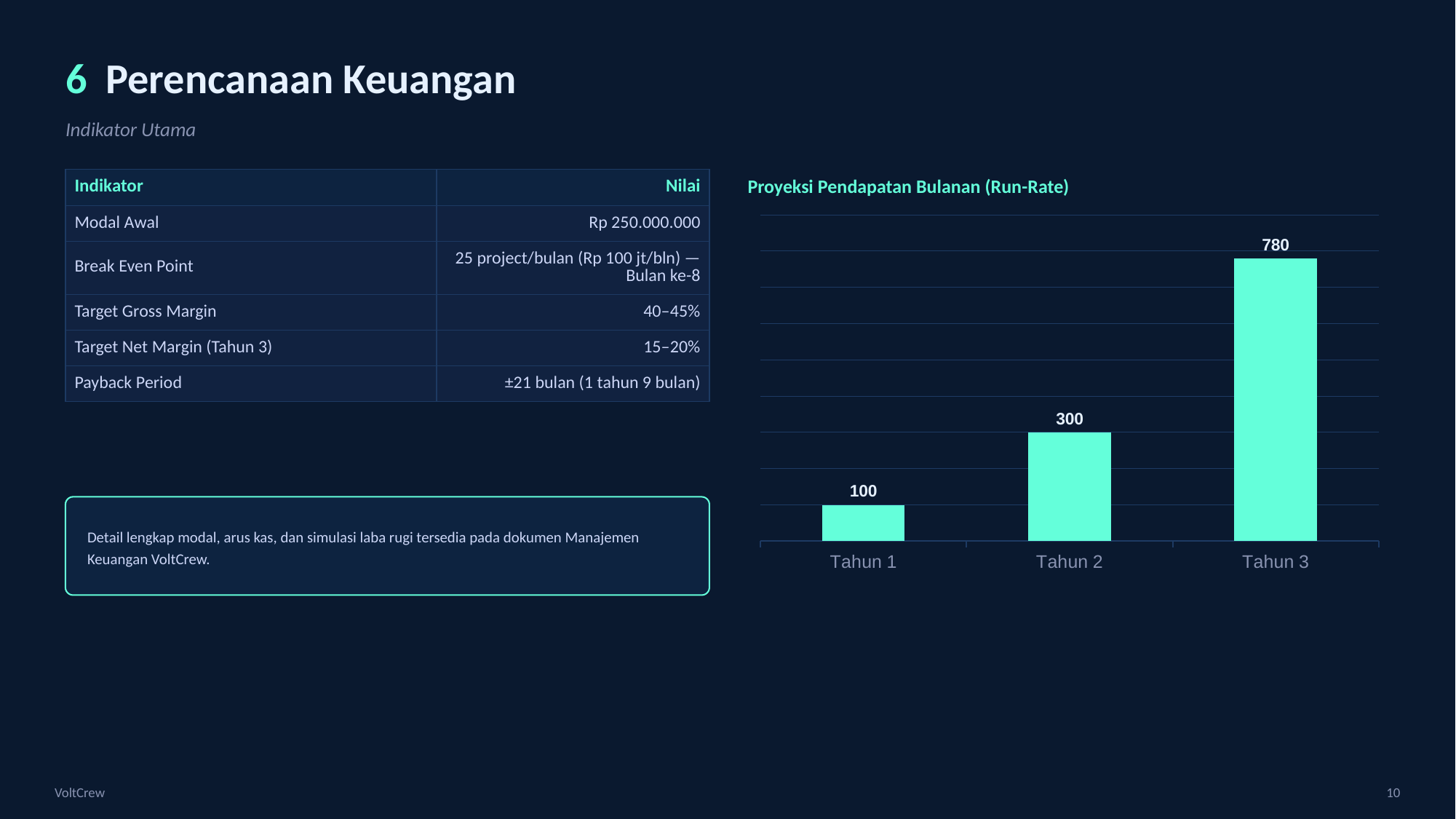
What is the value for Tahun 3 in the chart? 780 What kind of chart is shown on the slide? Bar chart What is the title of the chart? Proyeksi Pendapatan Bulanan (Run-Rate) Do the values rise or fall from Tahun 1 to Tahun 3? Rise Which is larger, the value for Tahun 2 or the value for Tahun 1? Tahun 2 What is the value for Tahun 2 in the chart? 300 What is the value for Tahun 1 in the chart? 100 What is the difference between the values for Tahun 2 and Tahun 1? 200 Which category has the highest value in the chart? Tahun 3 How many categories are shown on the x axis of the chart? 3 What is the difference between the values for Tahun 3 and Tahun 2? 480 Which category has the lowest value in the chart? Tahun 1